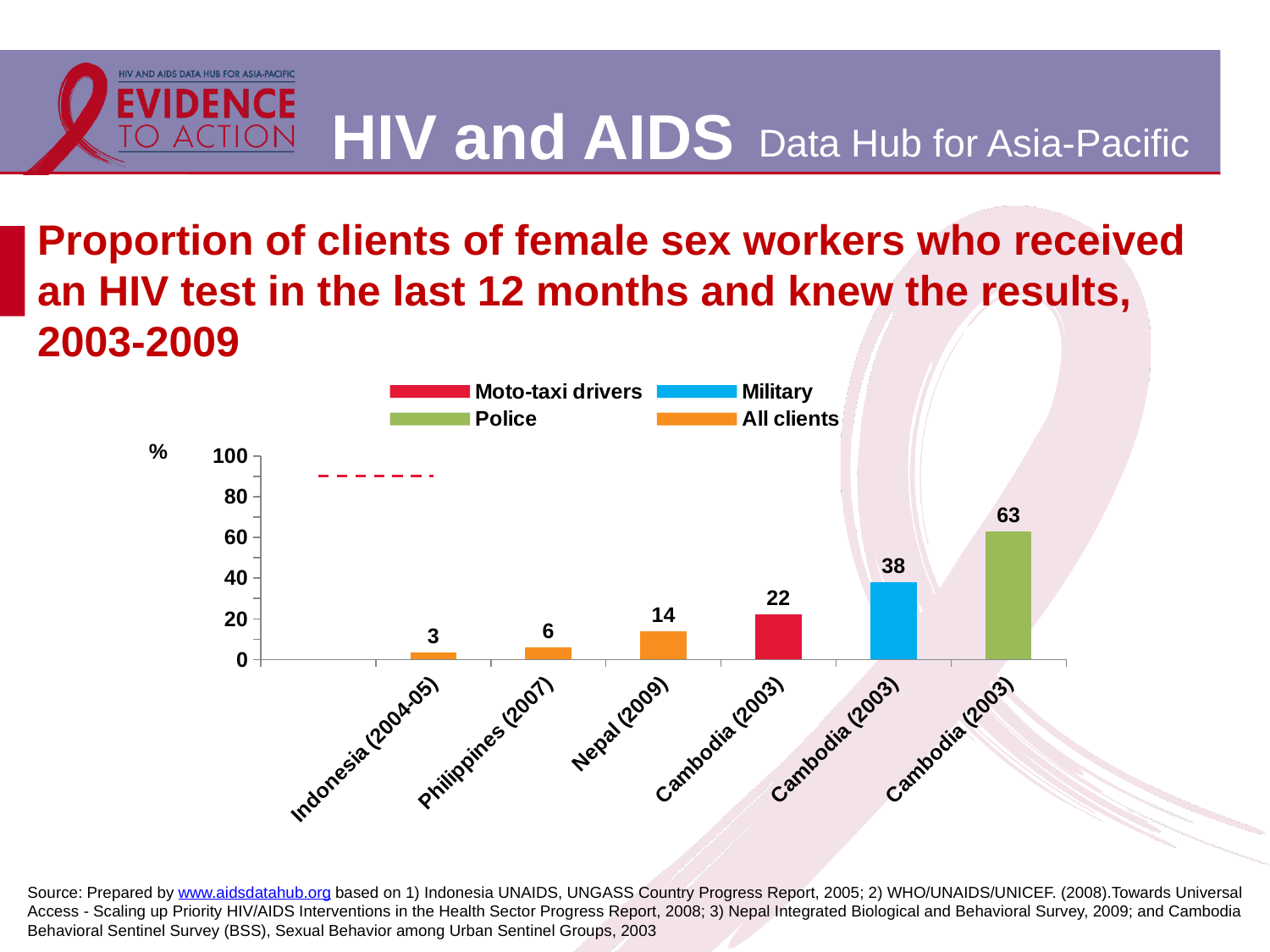
What is the value for Nepal (2009)? 14 Which category has the lowest value? Indonesia (2004-05) Which bar has the highest value? Cambodia (2003) Police Which is larger, the value for Nepal (2009) or the value for Philippines (2007)? Nepal (2009) What kind of chart is shown on the slide? Bar chart What is the value for the Military bar for Cambodia (2003)? 38 What is the difference between the Police and Military values for Cambodia (2003)? 25 What is the value for the Moto-taxi drivers bar for Cambodia (2003)? 22 What is the value for the Police bar for Cambodia (2003)? 63 How many series does the legend list? 4 What is the value for Indonesia (2004-05)? 3 What is the value for Philippines (2007)? 6